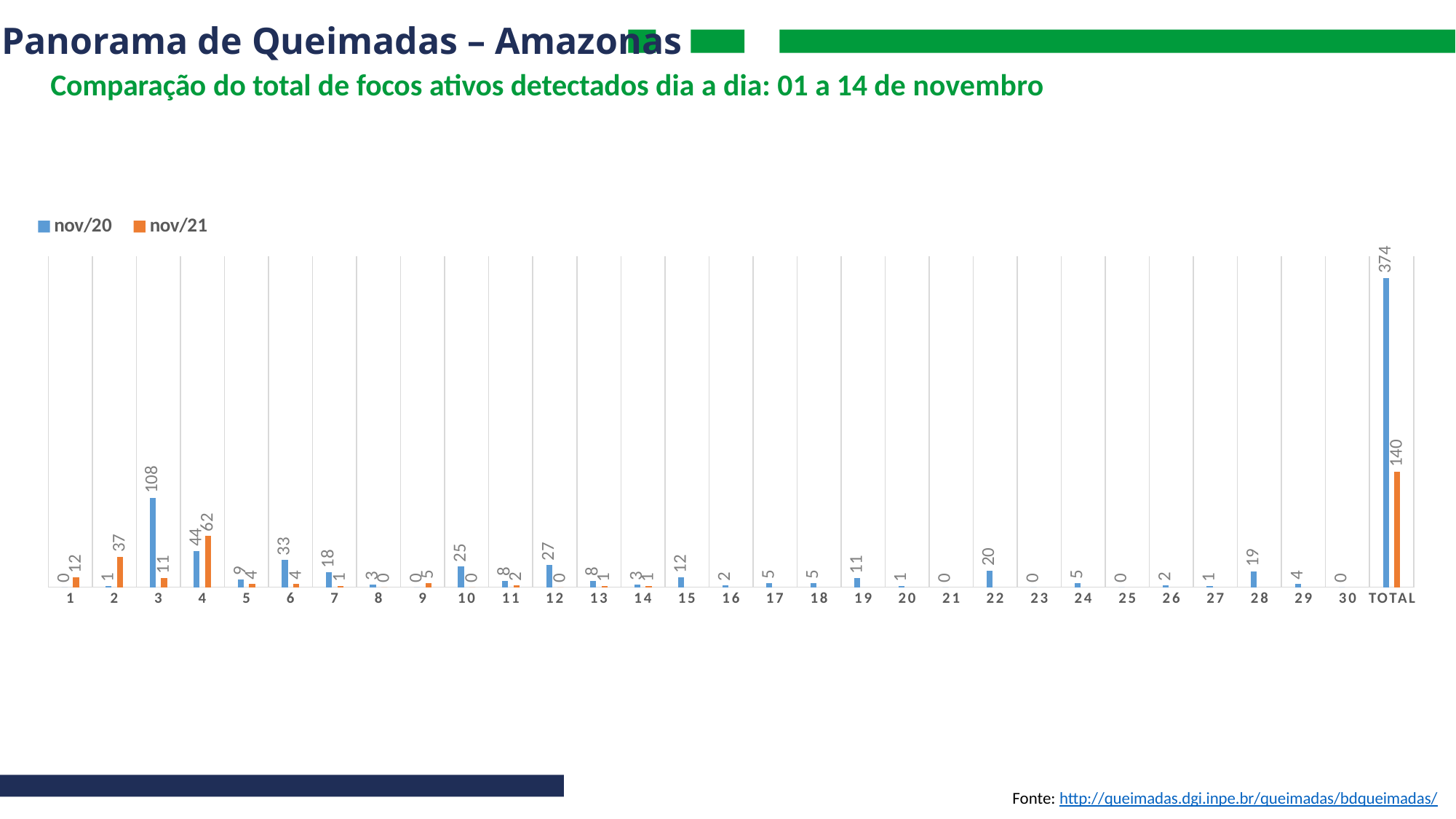
How many series does the legend list? 2 On day 4, which series has the larger value, nov/20 or nov/21? nov/21 What is the nov/20 value for day 3? 108 Excluding the TOTAL category, which day has the highest nov/21 value? 4 What is the difference between the nov/21 and nov/20 values on day 2? 36 What kind of chart is shown on the slide? Bar chart What is the difference between the nov/20 and nov/21 values in the TOTAL category? 234 What is the nov/20 value for day 22? 20 What is the nov/21 value for the TOTAL category? 140 Excluding the TOTAL category, which day has the highest nov/20 value? 3 What is the nov/21 value for day 4? 62 How many categories are shown on the x axis, including TOTAL? 31